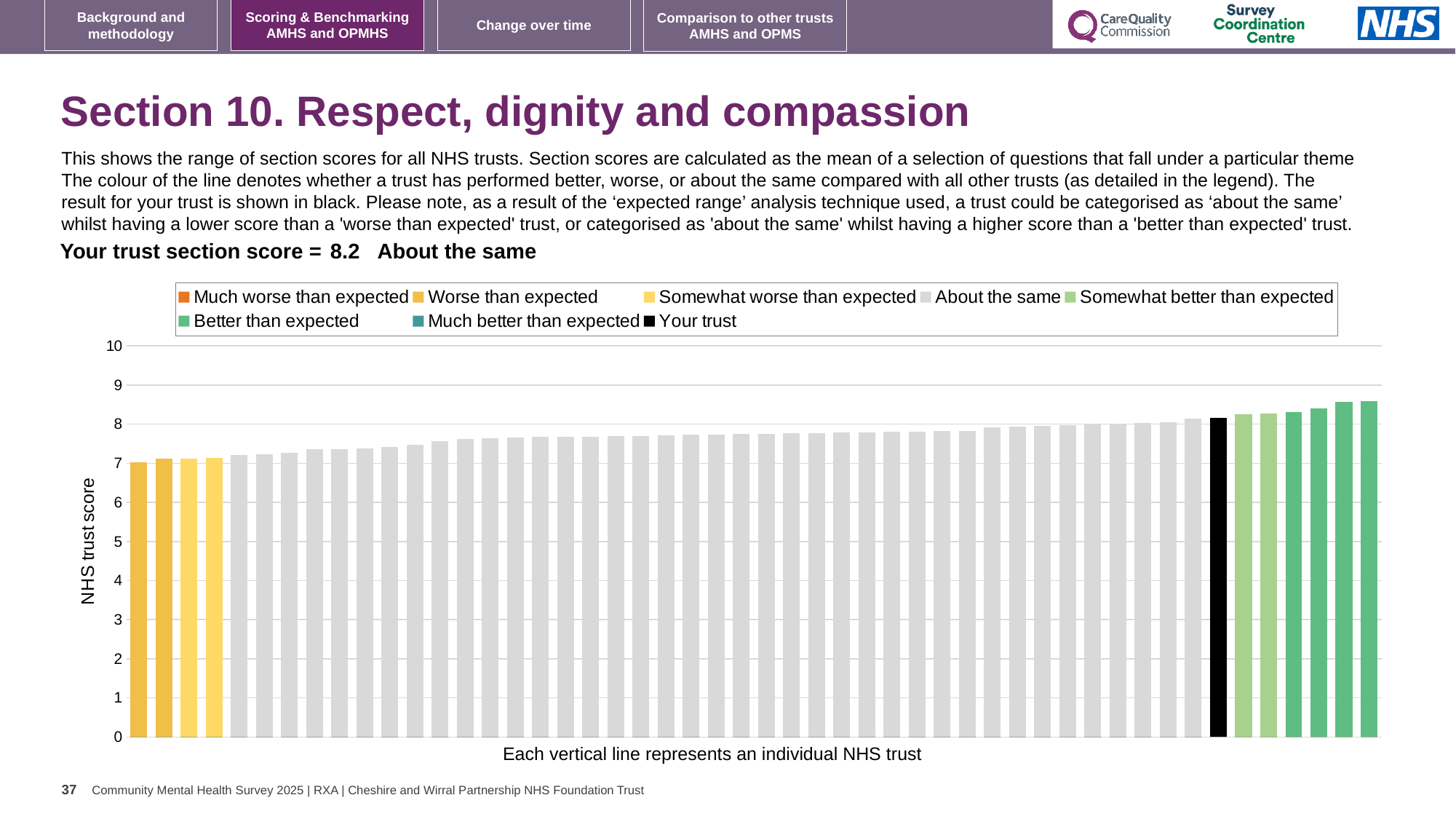
Is the value of the tallest bar greater or less than 8? greater Which is larger, the leftmost bar or the rightmost bar? the rightmost bar What is the section score for your trust? 8.2 What kind of chart is shown on the slide? bar chart Which category is your trust placed in for this section? About the same How many entries does the chart legend list? 8 Do the bar values rise or fall from left to right along the x axis? rise What is the label on the vertical axis of the chart? NHS trust score How many bars are coloured as 'Better than expected'? 4 Is the value of the lowest bar greater or less than 6? greater How many bars are coloured as 'Somewhat better than expected'? 2 Is the value of the lowest bar greater or less than 8? less